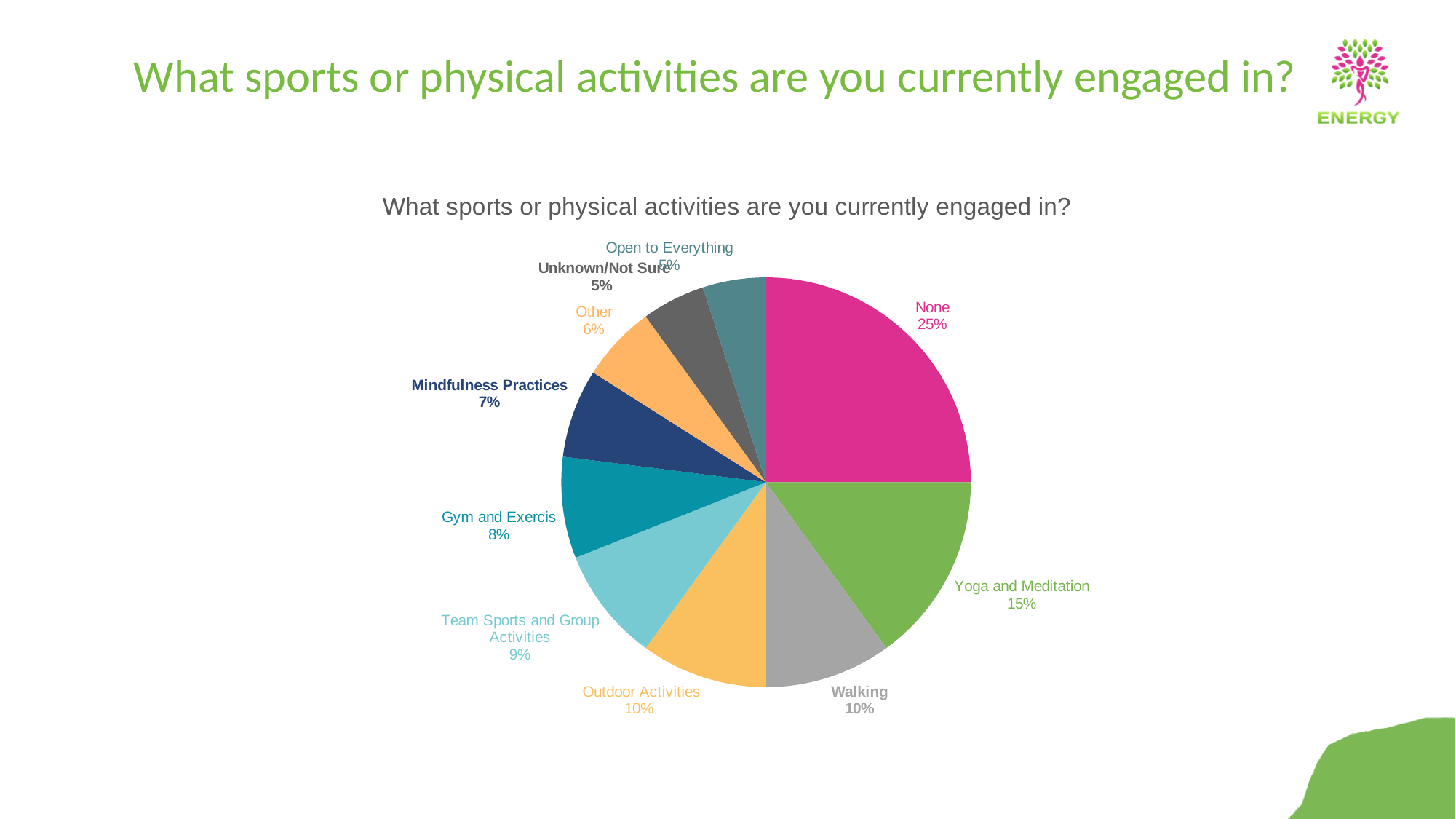
What percentage is shown for "Team Sports and Group Activities"? 9% What is the title of the chart? What sports or physical activities are you currently engaged in? How many slices does the pie chart have? 10 What percentage of respondents answered "None"? 25% What is the value shown for "Walking"? 10% Which is larger, "Outdoor Activities" or "Mindfulness Practices"? Outdoor Activities What is the value for "Mindfulness Practices"? 7% Which category has the largest slice of the pie? None What share of the pie is "Yoga and Meditation"? 15% What type of chart is shown on the slide? pie chart What is the difference in percentage points between "None" and "Yoga and Meditation"? 10 What percentage is labelled for "Other"? 6%